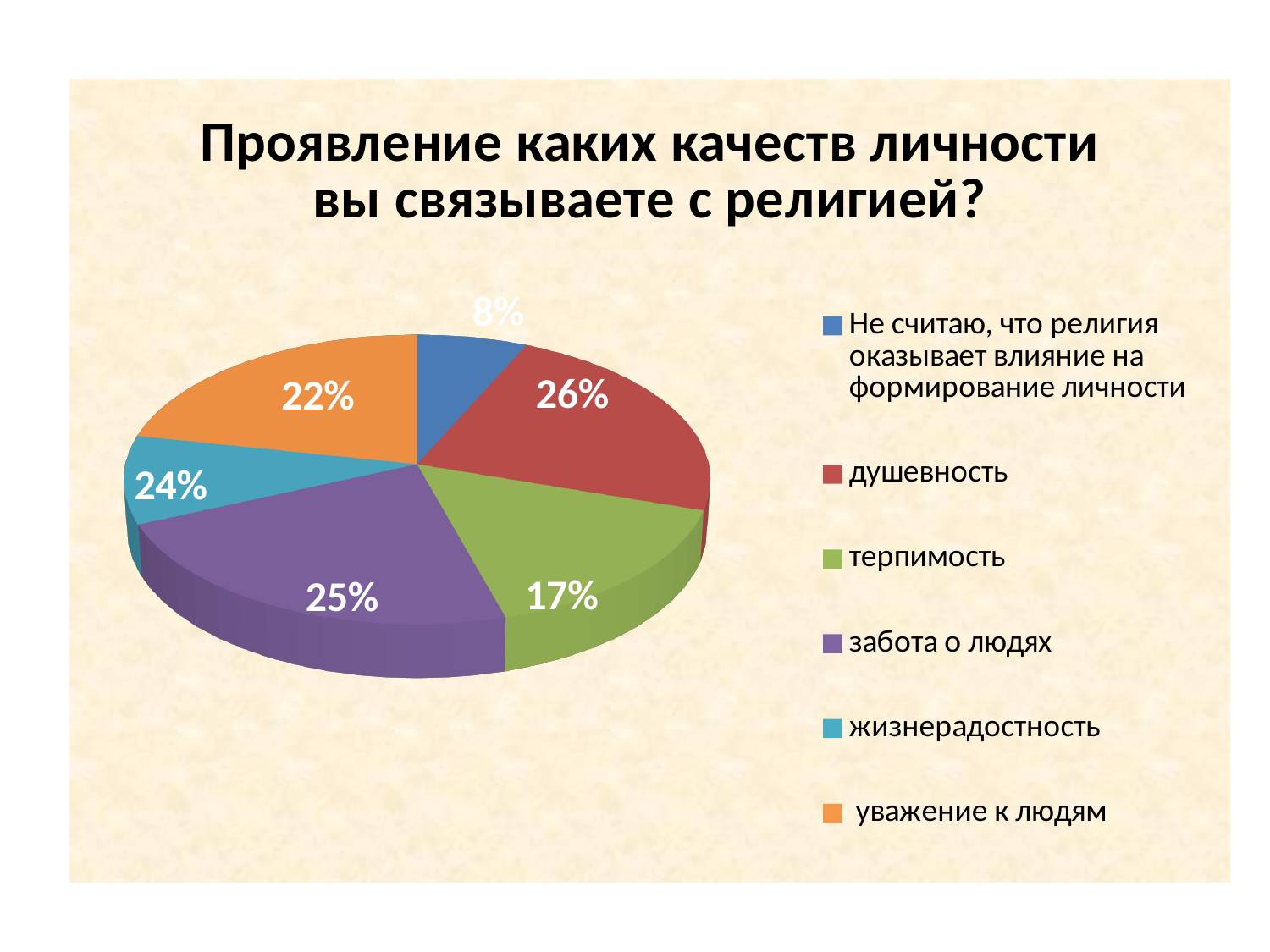
Which category has the largest share of the pie? душевность How many categories does the legend list? 6 What percentage is shown for уважение к людям? 22% What is the title of the chart? Проявление каких качеств личности вы связываете с религией? What percentage is shown for забота о людях? 25% What percentage is shown for жизнерадостность? 24% Which category has the smallest share of the pie? Не считаю, что религия оказывает влияние на формирование личности What kind of chart is shown on the slide? pie chart What is the difference in percentage points between душевность and терпимость? 9 What percentage is shown for терпимость? 17% What percentage is shown for душевность? 26%